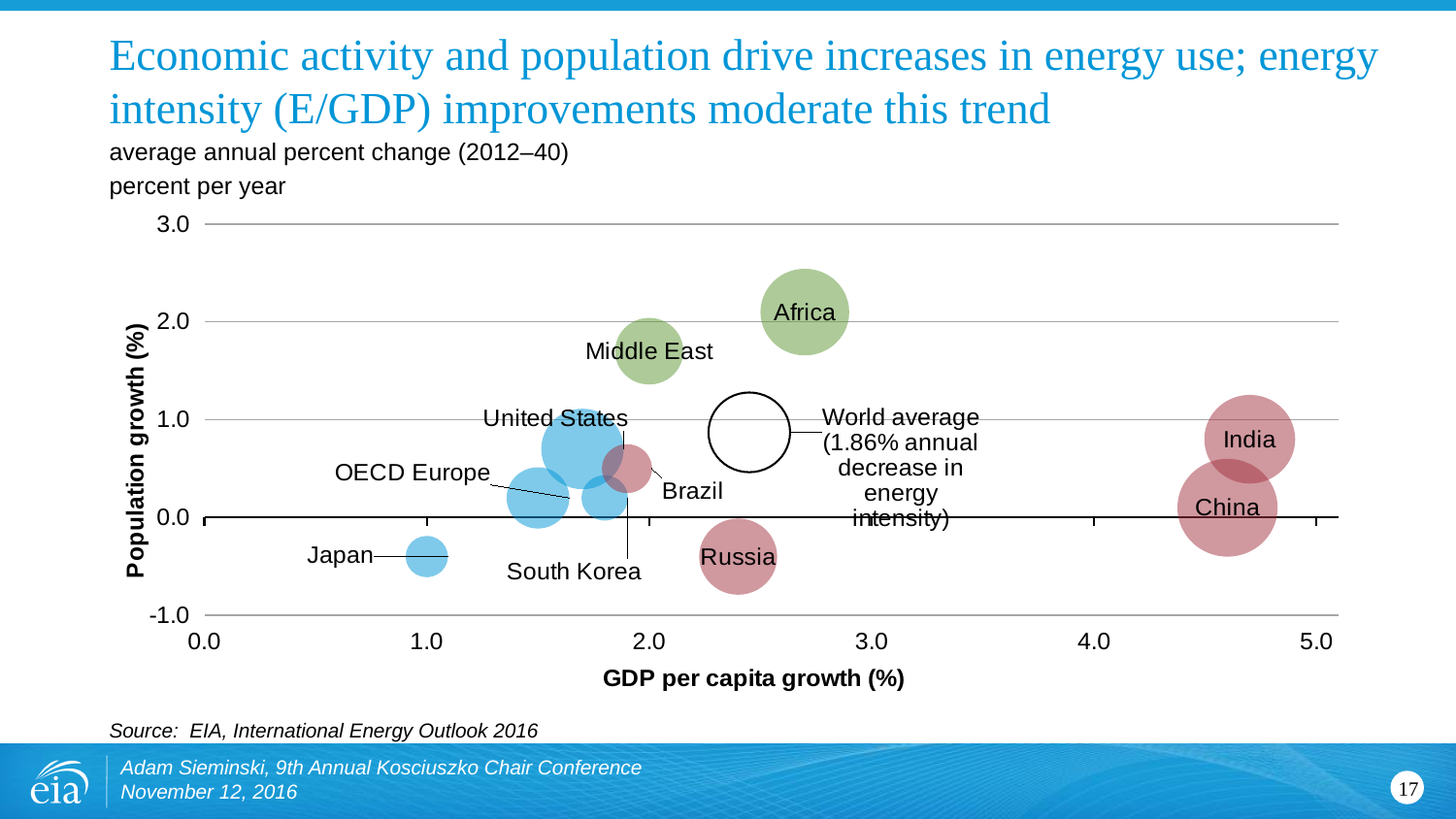
How many labeled bubbles, including the world average, are plotted on the chart? 11 Is the GDP per capita growth for Russia greater or less than 2.0? greater Which has higher GDP per capita growth, China or Japan? China What annual decrease in energy intensity is given for the world average? 1.86% Is the population growth for Middle East greater or less than 1.0? greater Which country or region has the highest population growth on the chart? Africa What is the title of the vertical axis? Population growth (%) Which has higher population growth, Africa or Middle East? Africa Is the GDP per capita growth for China greater or less than 4.0? greater What kind of chart is shown on the slide? bubble chart What is the title of the horizontal axis? GDP per capita growth (%)